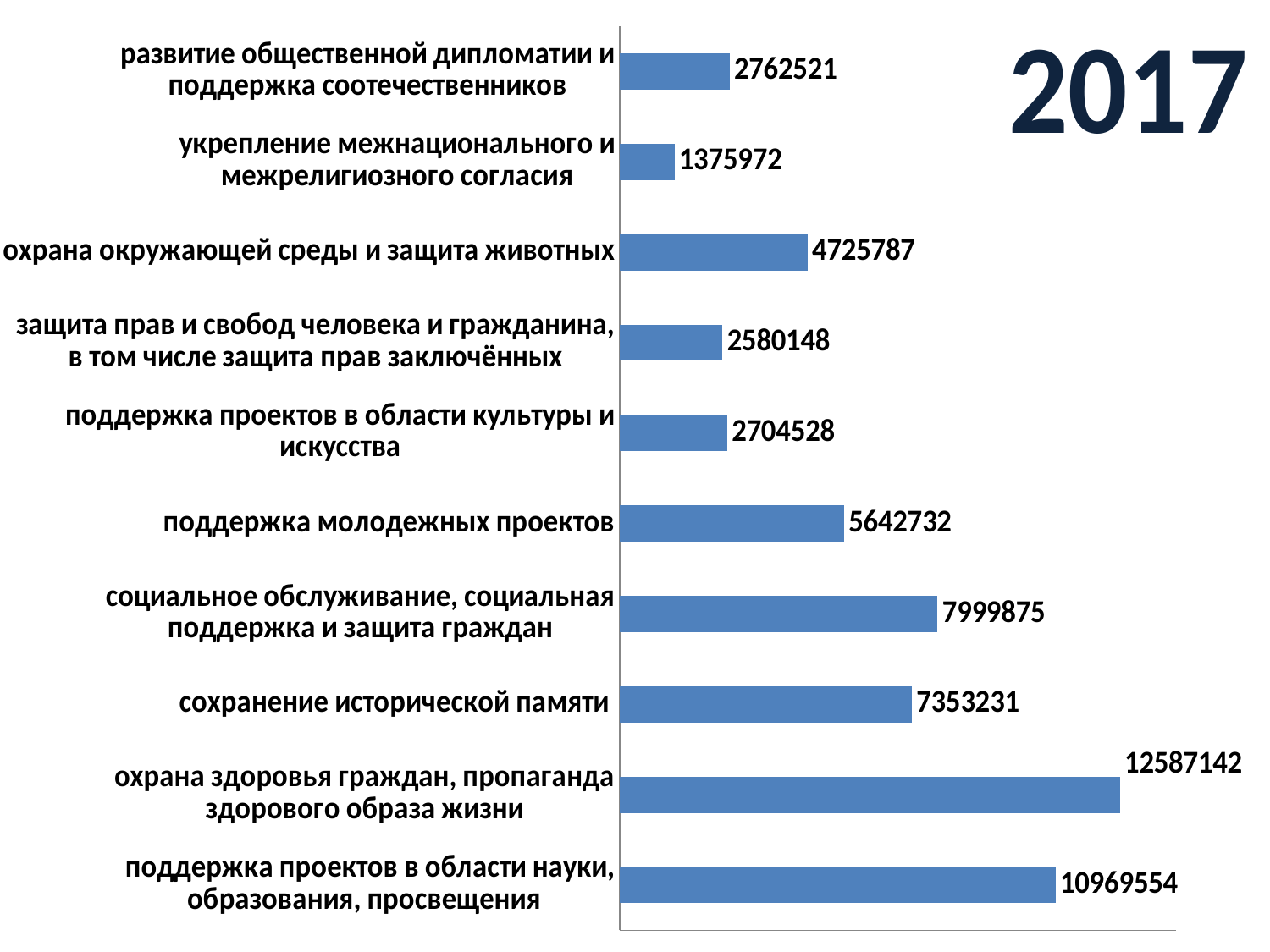
What kind of chart is shown on the slide? bar chart What is the difference between the values for «социальное обслуживание, социальная поддержка и защита граждан» and «сохранение исторической памяти»? 646644 Which category has the lowest value? укрепление межнационального и межрелигиозного согласия What is the value for «поддержка молодежных проектов»? 5642732 What is the value for «сохранение исторической памяти»? 7353231 What year is shown as the title of the chart? 2017 What is the value for «охрана здоровья граждан, пропаганда здорового образа жизни»? 12587142 What is the difference between the values for «охрана здоровья граждан, пропаганда здорового образа жизни» and «поддержка проектов в области науки, образования, просвещения»? 1617588 What is the value for «укрепление межнационального и межрелигиозного согласия»? 1375972 How many categories are shown in the chart? 10 Which is larger: the value for «поддержка молодежных проектов» or for «охрана окружающей среды и защита животных»? поддержка молодежных проектов Which category has the highest value? охрана здоровья граждан, пропаганда здорового образа жизни